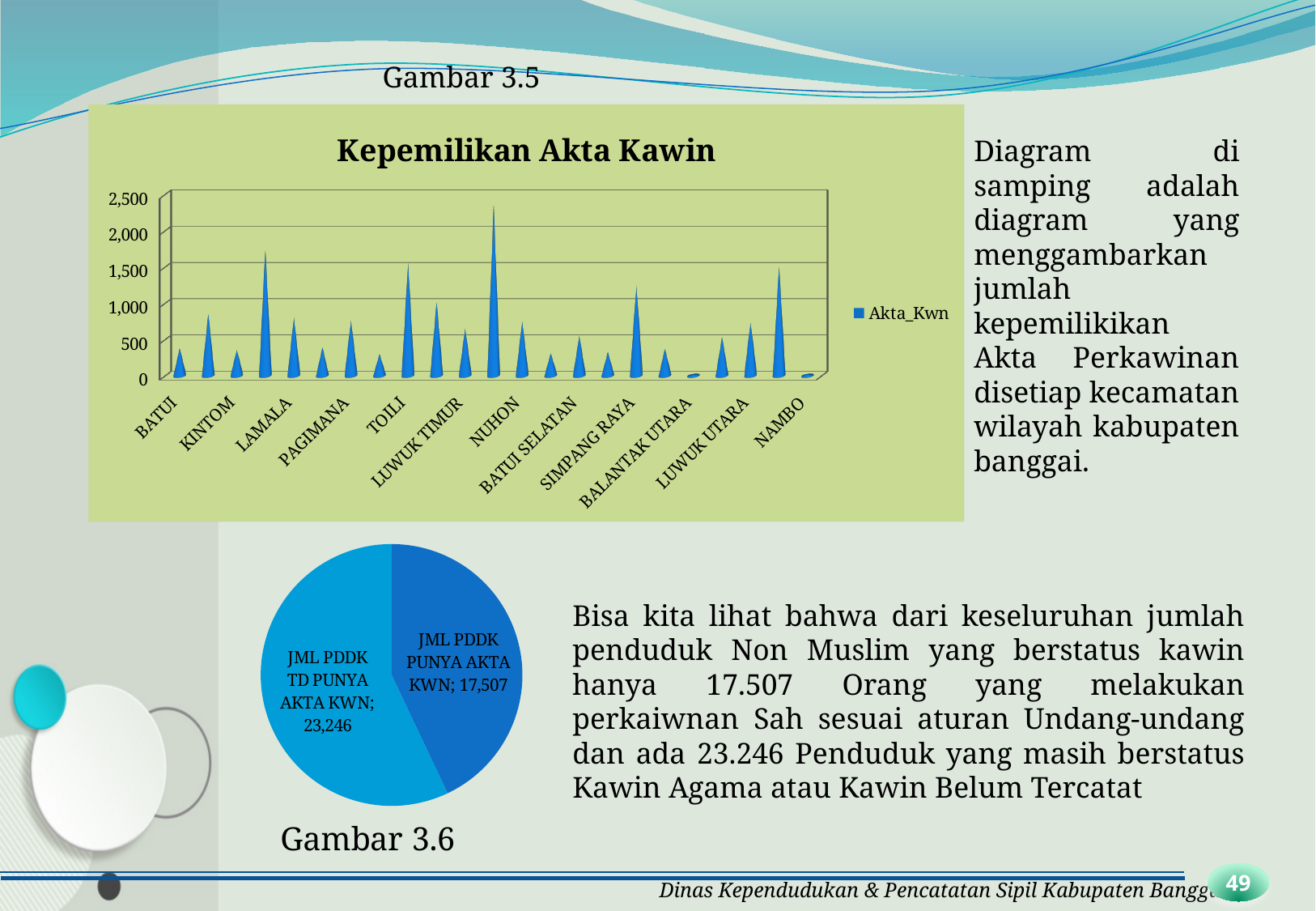
In the top chart 'Kepemilikan Akta Kawin', what is the highest value shown on the vertical axis? 2,500 In the top chart 'Kepemilikan Akta Kawin', what is the name of the series shown in the legend? Akta_Kwn In the top chart 'Kepemilikan Akta Kawin', is the highest value greater or less than 2,000? greater In the pie chart (Gambar 3.6), which slice is larger: JML PDDK PUNYA AKTA KWN or JML PDDK TD PUNYA AKTA KWN? JML PDDK TD PUNYA AKTA KWN In the pie chart (Gambar 3.6), what is the total of the two slices? 40,753 In the top chart 'Kepemilikan Akta Kawin', how many series does the legend list? 1 What is the title of the top chart? Kepemilikan Akta Kawin What kind of chart is Gambar 3.6 at the bottom of the slide? pie chart In the pie chart (Gambar 3.6), what is the value for JML PDDK TD PUNYA AKTA KWN? 23,246 How many slices does the pie chart (Gambar 3.6) have? 2 In the pie chart (Gambar 3.6), what is the difference between JML PDDK TD PUNYA AKTA KWN and JML PDDK PUNYA AKTA KWN? 5,739 In the pie chart (Gambar 3.6), what is the value for JML PDDK PUNYA AKTA KWN? 17,507